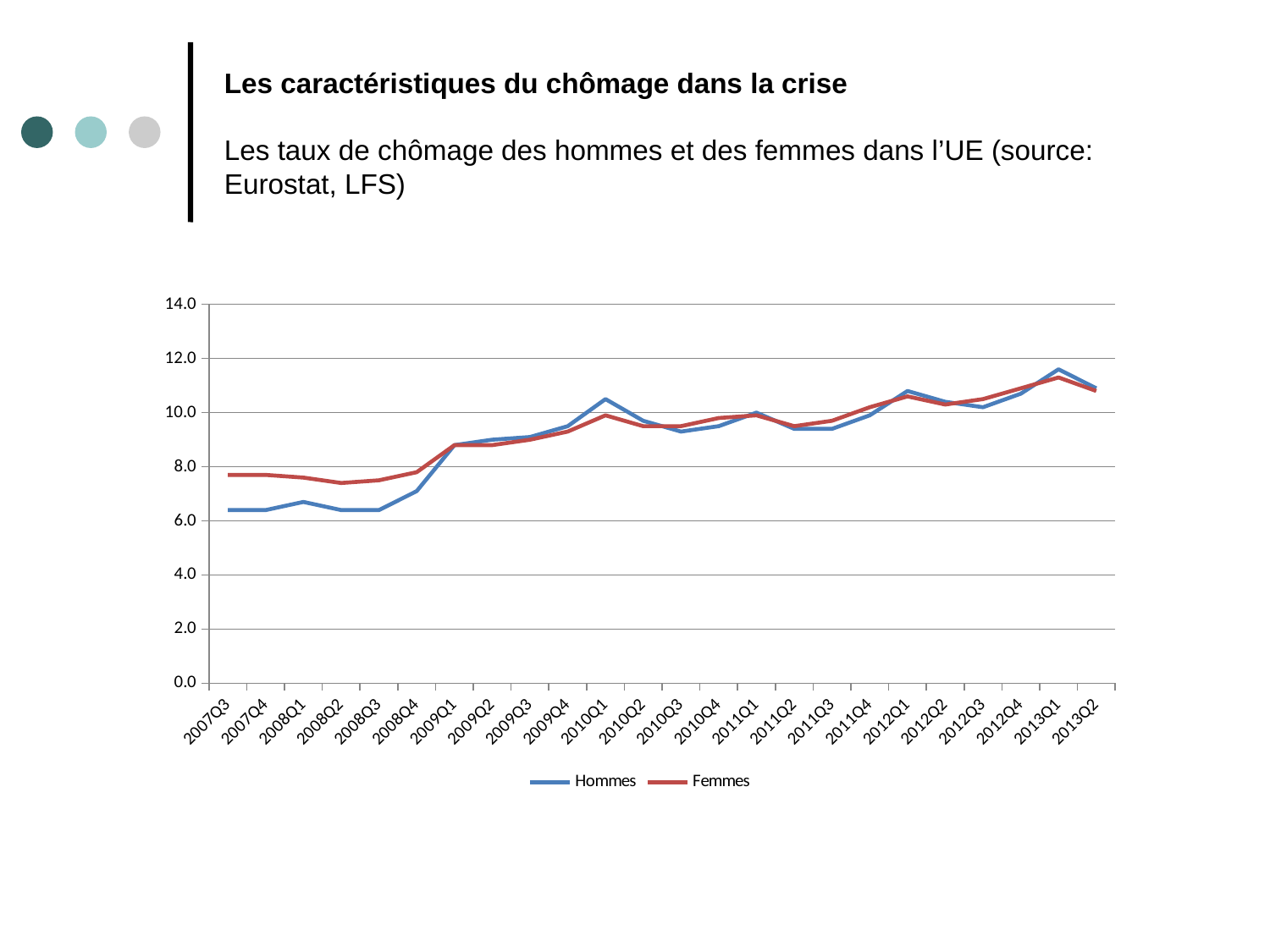
Is the value for Femmes in 2013Q1 greater or less than 10.0? greater Is the value for Hommes in 2007Q3 greater or less than 8.0? less In 2010Q1, which series has the higher value, Hommes or Femmes? Hommes Overall, do the unemployment rates rise or fall from 2007Q3 to 2013Q2? Rise Which colour is used for the Hommes series? Blue How many series does the legend list? 2 What is the last quarter shown on the x axis? 2013Q2 What kind of chart is shown on the slide? Line chart What are the two series named in the legend? Hommes and Femmes What is the first quarter shown on the x axis? 2007Q3 How many quarters are shown along the x axis? 24 In 2007Q3, which series has the higher value, Hommes or Femmes? Femmes